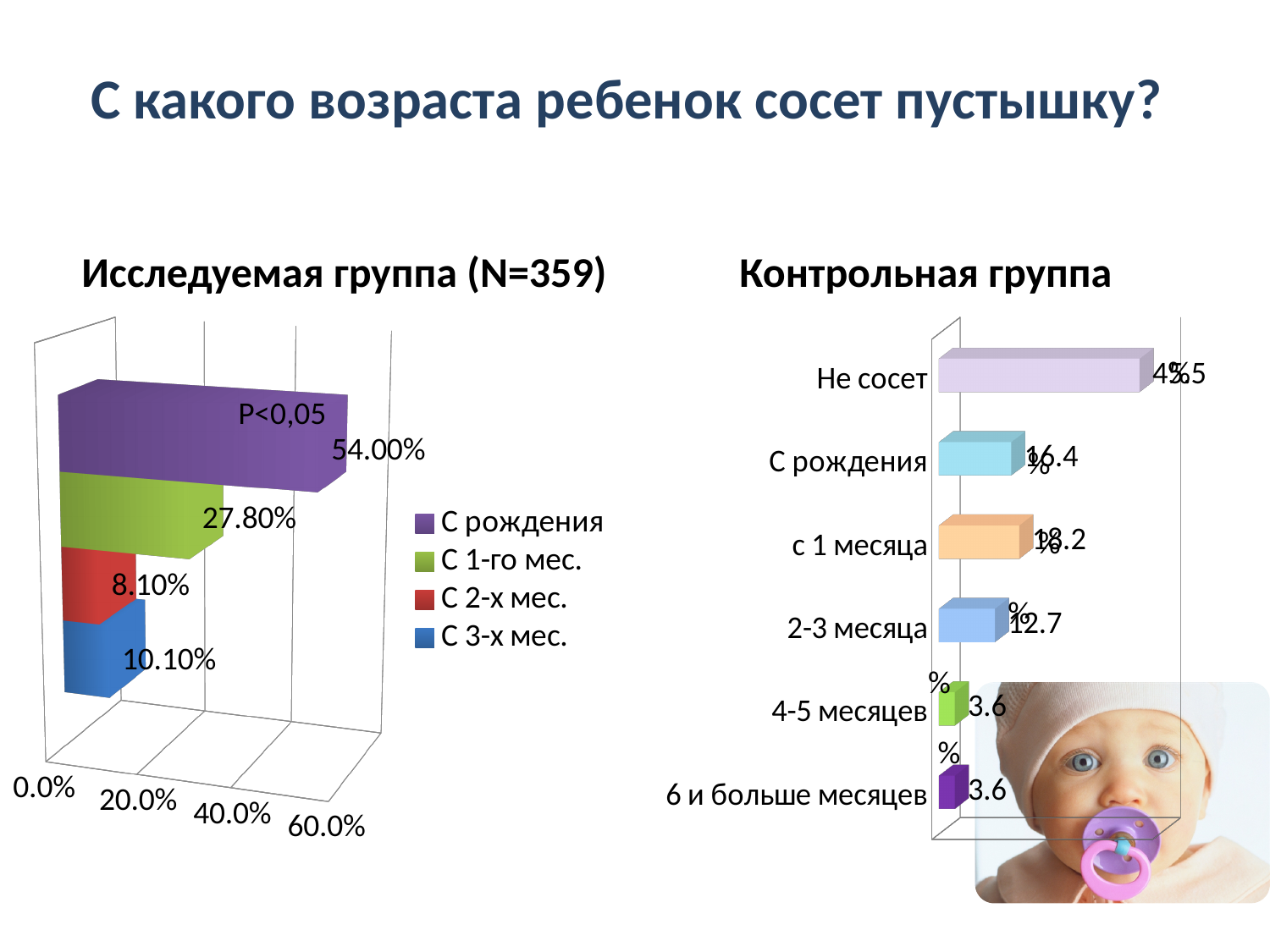
In the chart titled 'Исследуемая группа (N=359)', what is the difference between the values for 'С рождения' and 'С 1-го мес.'? 26.20% In the chart titled 'Контрольная группа', which category has the highest value? Не сосет In the chart titled 'Контрольная группа', what is the value for '2-3 месяца'? 12.7 In the chart titled 'Исследуемая группа (N=359)', what is the value for 'С 1-го мес.'? 27.80% In the chart titled 'Исследуемая группа (N=359)', what is the value for 'С рождения'? 54.00% In the chart titled 'Контрольная группа', how many categories are shown? 6 What kind of chart is the one titled 'Контрольная группа'? Bar chart In the chart titled 'Исследуемая группа (N=359)', which category has the lowest value? С 2-х мес. In the chart titled 'Исследуемая группа (N=359)', how many entries does the legend list? 4 In the chart titled 'Контрольная группа', what is the value for '4-5 месяцев'? 3.6 In the chart titled 'Исследуемая группа (N=359)', what is the value for 'С 3-х мес.'? 10.10% In the chart titled 'Исследуемая группа (N=359)', what statistical annotation is printed next to the top bar? P<0,05